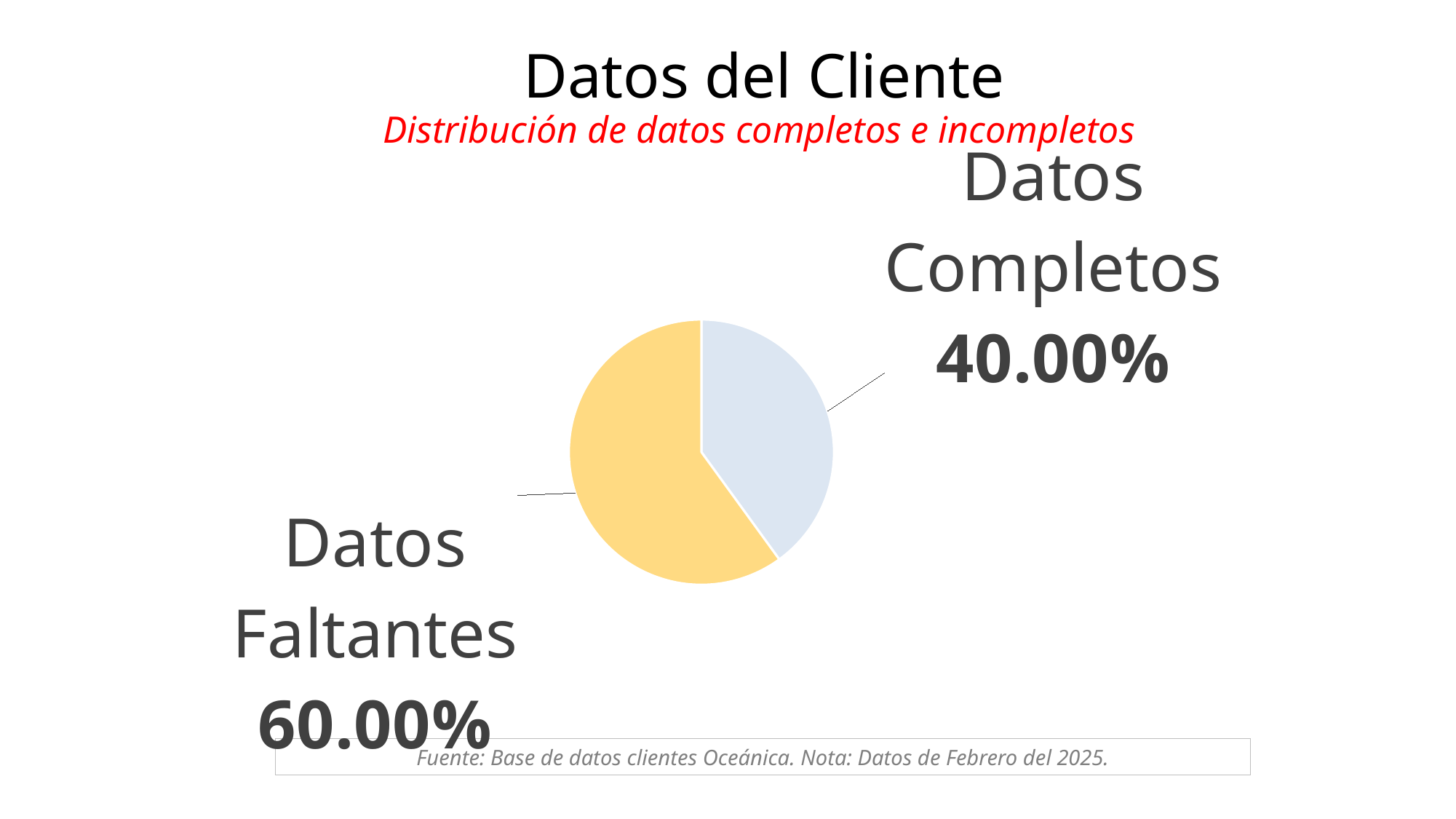
Which is larger, Datos Completos or Datos Faltantes? Datos Faltantes What is the title of the chart? Datos del Cliente Which slice is the largest? Datos Faltantes What share of the pie is labelled Datos Faltantes? 60.00% What kind of chart is shown on the slide? pie chart What share of the pie is labelled Datos Completos? 40.00% Which slice is the smallest? Datos Completos How many slices does the pie chart have? 2 What colour is the Datos Faltantes slice? yellow What is the difference between the Datos Faltantes share and the Datos Completos share? 20.00%